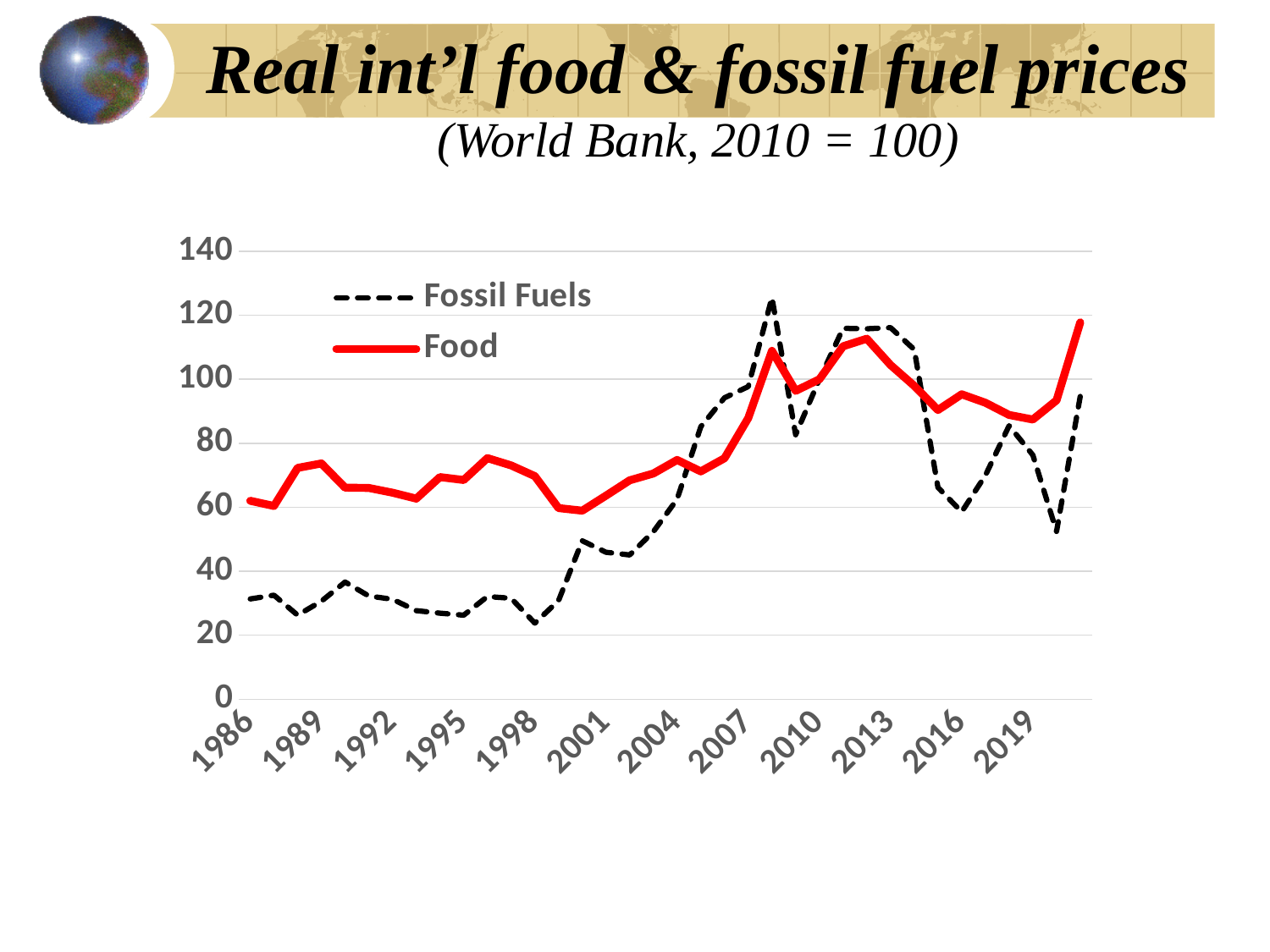
Is the value for Fossil Fuels in 1998 greater or less than 40? less Is the value for Food in 1986 greater or less than 40? greater What are the two series named in the legend? Fossil Fuels and Food Is the value for Food in 2013 greater or less than 100? greater In 2016, which series has the higher value, Food or Fossil Fuels? Food In 2007, which series has the higher value, Food or Fossil Fuels? Fossil Fuels How many series does the legend list? 2 What kind of chart is shown on the slide? line chart What is the base year in which the index equals 100, according to the subtitle? 2010 Does the Food series rise or fall overall between 2013 and 2019? fall